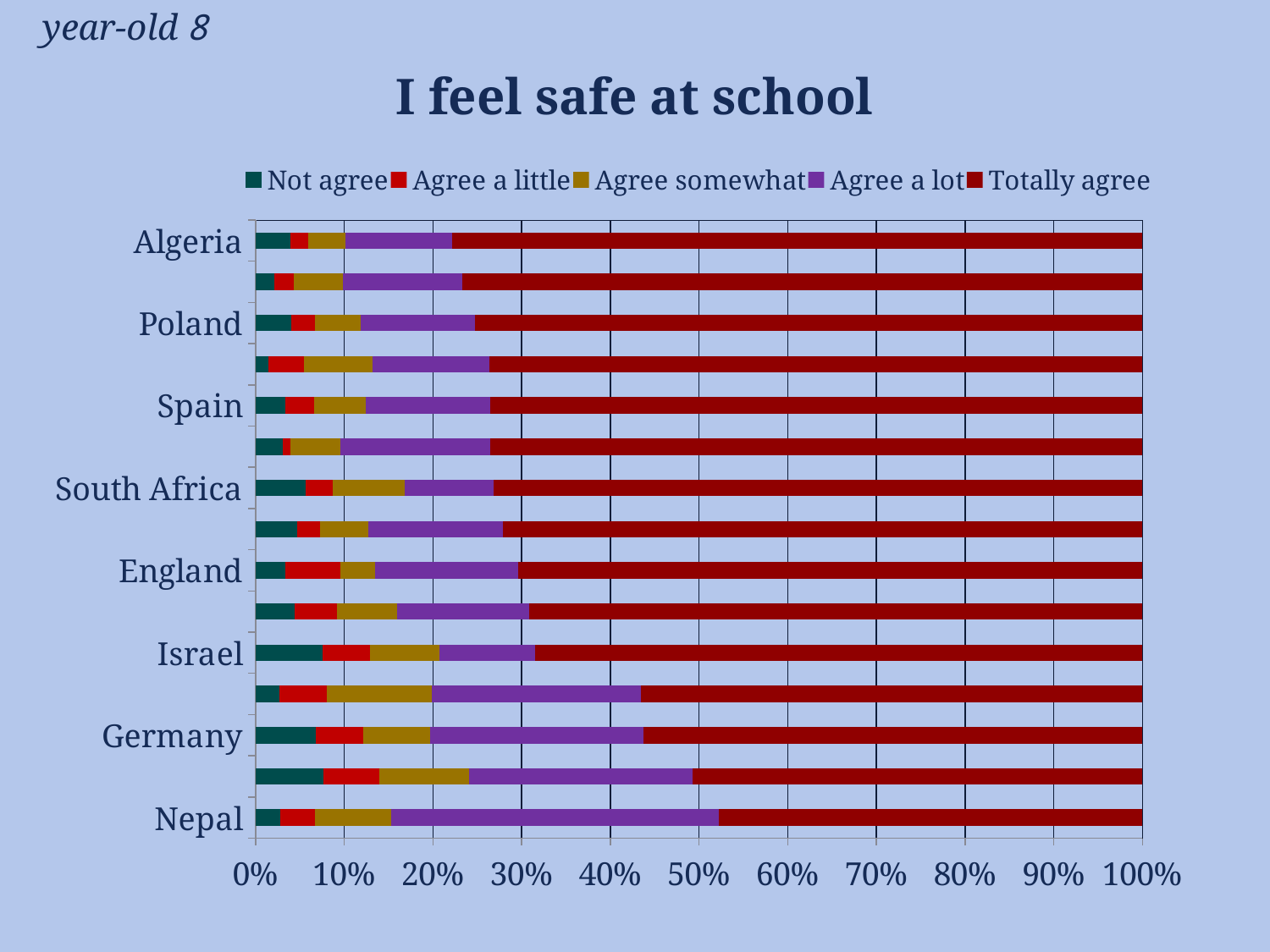
What is the title of the chart? I feel safe at school How many series does the legend list? 5 Going down the chart from Algeria to Nepal, does the 'Totally agree' share rise or fall? fall Which has the larger 'Not agree' share, Israel or Algeria? Israel Which labelled country has the smallest 'Totally agree' share? Nepal Is the 'Totally agree' share for Nepal greater or less than 60%? less Which labelled country has the largest 'Totally agree' share? Algeria Is the 'Totally agree' share for Algeria greater or less than 70%? greater What kind of chart is shown on the slide? Stacked bar chart Which series is shown in dark red in the chart? Totally agree Is the 'Agree a lot' share for Nepal greater or less than 30%? greater How many country labels are shown on the vertical axis? 8